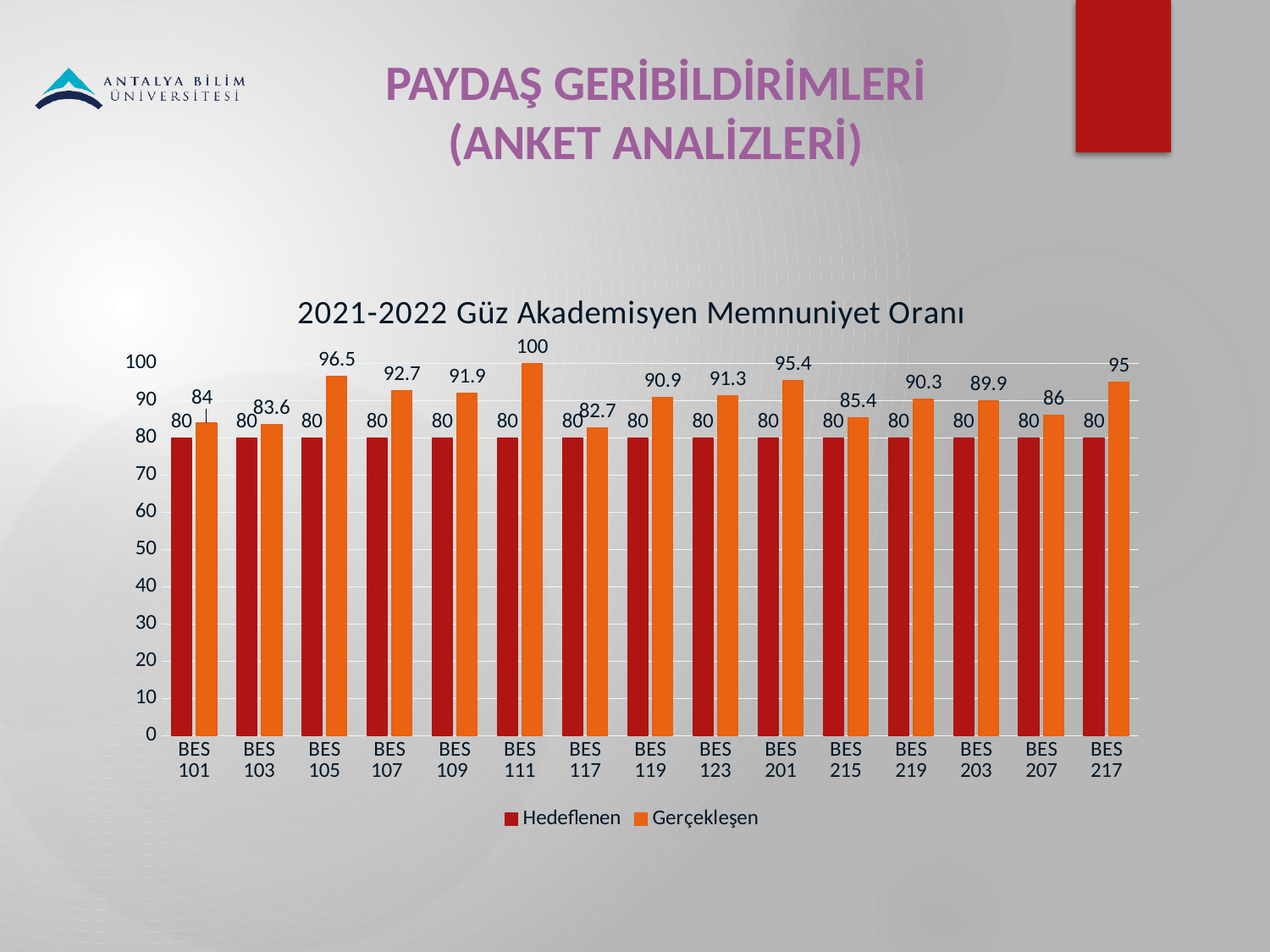
What is the difference between the Gerçekleşen and Hedeflenen values for BES 201? 15.4 Which category has the lowest Gerçekleşen value? BES 117 How many categories are shown on the x axis? 15 Which category has the highest Gerçekleşen value? BES 111 How many series does the legend list? 2 What is the Gerçekleşen value for BES 117? 82.7 What kind of chart is shown on the slide? Bar chart What is the Hedeflenen value for BES 201? 80 What is the Gerçekleşen value for BES 105? 96.5 Which is larger, the Gerçekleşen value for BES 107 or for BES 219? BES 107 What is the title of the chart? 2021-2022 Güz Akademisyen Memnuniyet Oranı What are the two series named in the legend? Hedeflenen and Gerçekleşen